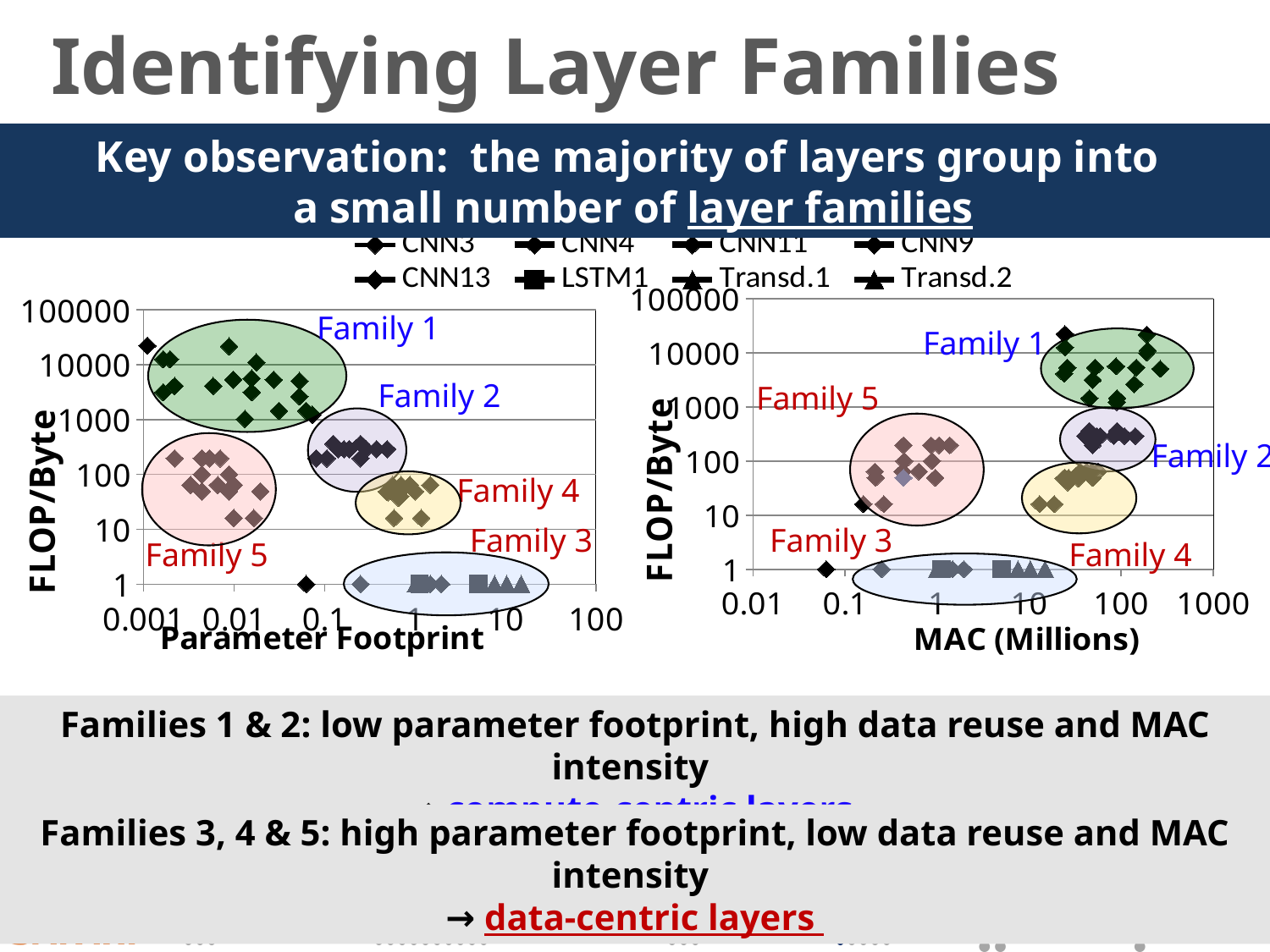
In the right chart (MAC (Millions)), which has higher FLOP/Byte values, Family 2 or Family 4? Family 2 Which legend series is shown with a square marker? LSTM1 What is the x-axis title of the right chart? MAC (Millions) In the right chart (MAC (Millions)), are the Family 1 points at a FLOP/Byte greater or less than 1000? greater In the left chart (Parameter Footprint), which labeled family has the lowest FLOP/Byte values? Family 3 What kind of chart is the left chart with the x-axis 'Parameter Footprint'? scatter chart In the right chart (MAC (Millions)), which labeled family has the highest FLOP/Byte values? Family 1 How many series does the legend above the charts list? 8 In the left chart (Parameter Footprint), are the Family 3 points at a FLOP/Byte greater or less than 10? less How many layer families are labeled on the left chart? 5 In the left chart (Parameter Footprint), are the Family 2 points at a FLOP/Byte greater or less than 100? greater